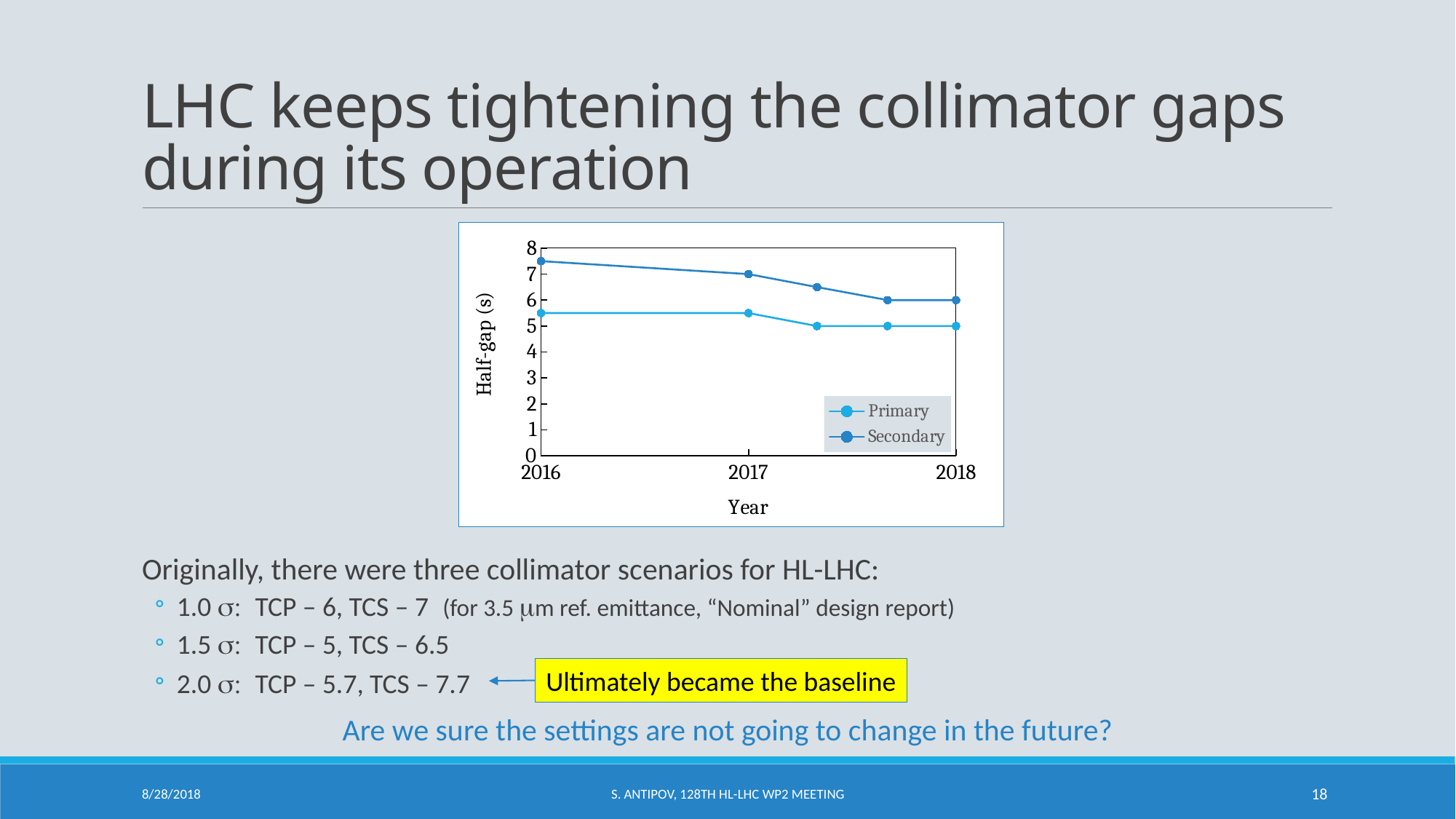
What is the label of the y axis? Half-gap (σ) What are the two series named in the legend? Primary and Secondary What is the Secondary half-gap value at 2018? 6 Do the Secondary half-gap values rise or fall from 2016 to 2018? fall How many series does the legend list? 2 Is the Primary half-gap value at 2016 greater or less than 5? greater What kind of chart is shown on the slide? line chart How many data points are plotted for the Secondary series? 5 What is the Secondary half-gap value at 2017? 7 What is the Primary half-gap value at 2018? 5 Which series has the larger half-gap at 2016, Primary or Secondary? Secondary Is the Secondary half-gap value at 2016 greater or less than 7? greater